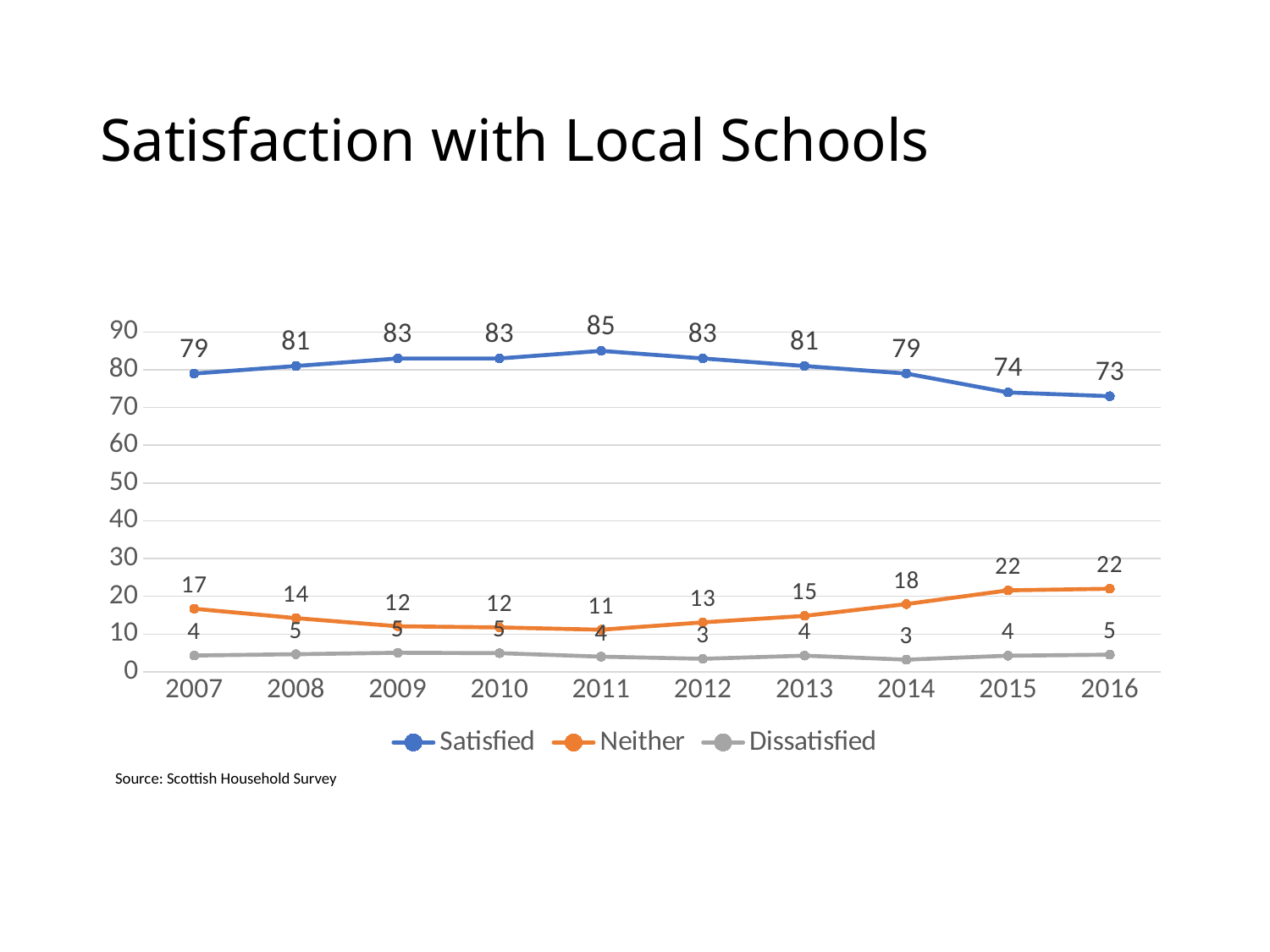
How many years are shown on the x axis? 10 What kind of chart is shown on the slide? line chart In which year is the Satisfied series lowest? 2016 What is the Neither value for 2014? 18 In which year is the Satisfied series highest? 2011 Which is larger, the Neither value for 2007 or the Neither value for 2011? 2007 What is the title of the chart? Satisfaction with Local Schools Does the Neither series rise or fall from 2011 to 2016? rise What is the Dissatisfied value for 2016? 5 What is the difference between the Satisfied values for 2011 and 2016? 12 What is the Satisfied value for 2011? 85 How many series does the legend list? 3